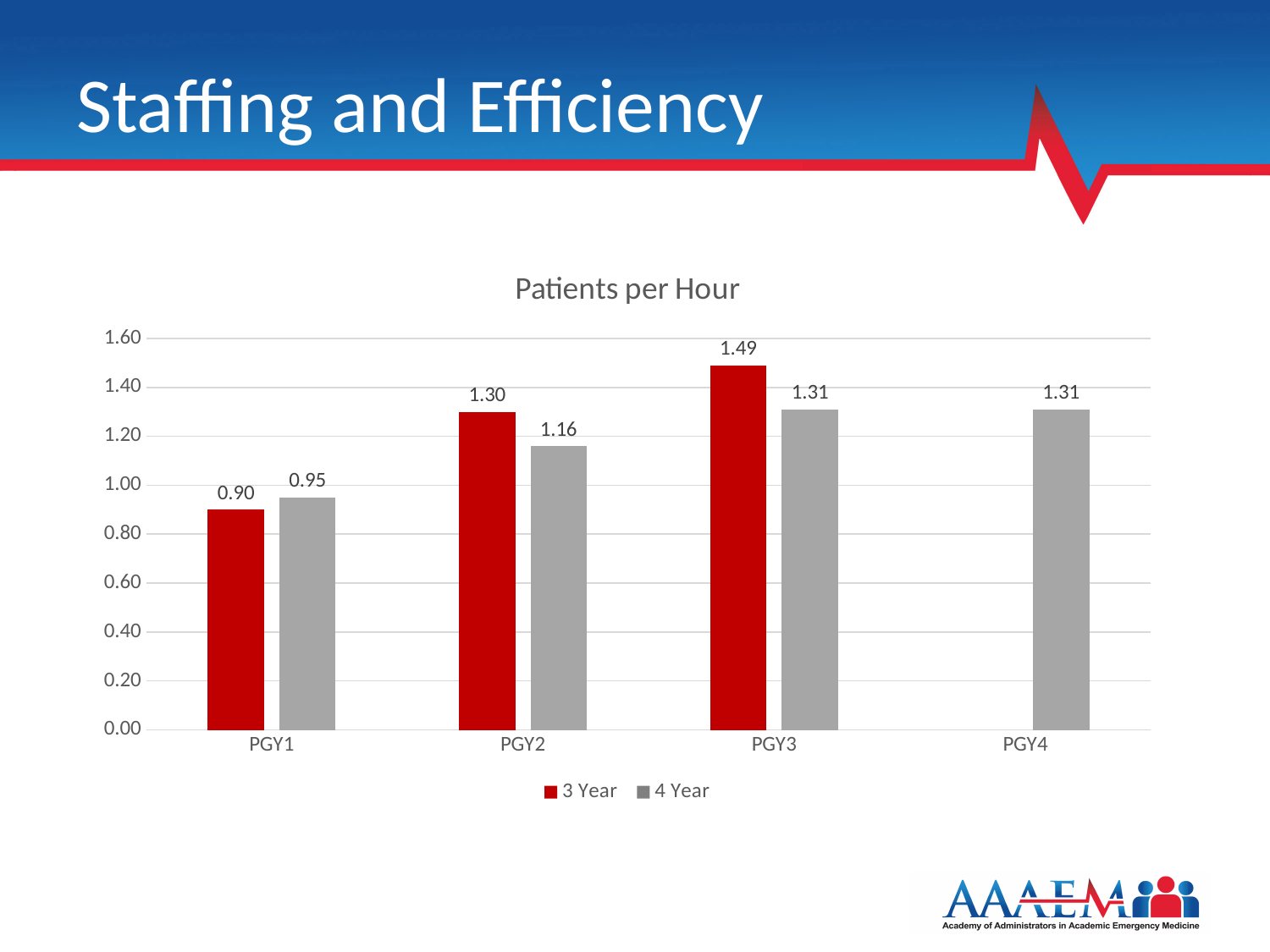
Which category has the lowest value for the 4 Year series? PGY1 How many categories are shown on the x axis? 4 What is the title of the chart? Patients per Hour What is the value for the 4 Year series at PGY4? 1.31 What is the value for the 3 Year series at PGY2? 1.30 Which category has the highest value for the 3 Year series? PGY3 How many series does the legend list? 2 What kind of chart is shown on the slide? bar chart What is the value for the 4 Year series at PGY1? 0.95 At PGY2, which series has the larger value, 3 Year or 4 Year? 3 Year What is the difference between the 3 Year and 4 Year values at PGY3? 0.18 Is the value for the 3 Year series at PGY1 greater or less than 1.00? less